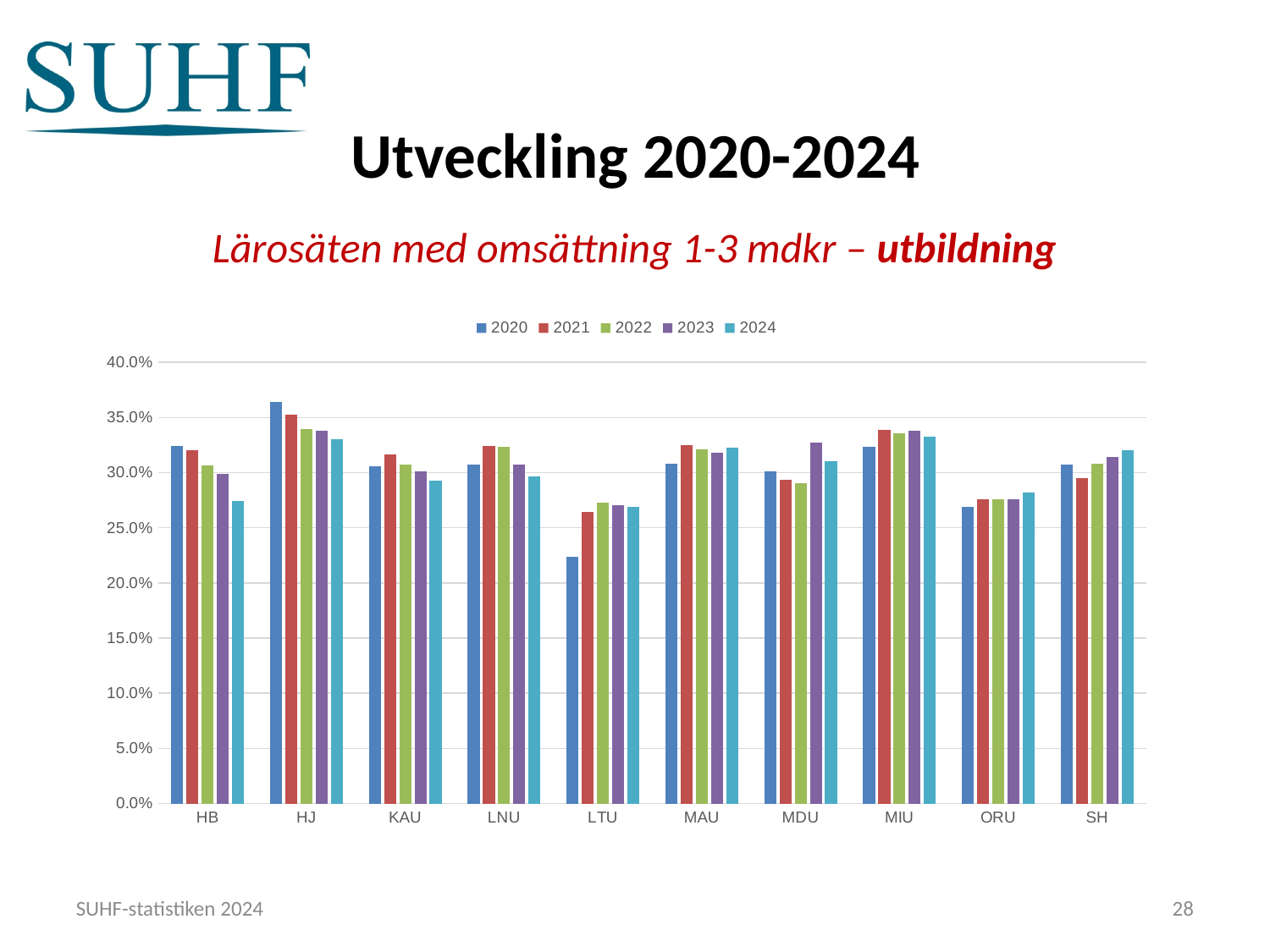
Which year is shown in the first (leftmost) bar of each group according to the legend? 2020 Is the 2020 value for LTU greater or less than 25.0%? less Which category has the highest bar in the chart? HJ Is the 2020 value for HJ greater or less than 35.0%? greater Do the values for HB rise or fall from 2020 to 2024? fall Which is larger for HB: the 2020 value or the 2024 value? 2020 Which category has the lowest bar in the chart? LTU Is the 2024 value for MIU greater or less than 30.0%? greater How many categories (lärosäten) are shown on the x axis? 10 What kind of chart is shown on the slide? bar chart How many series does the legend list? 5